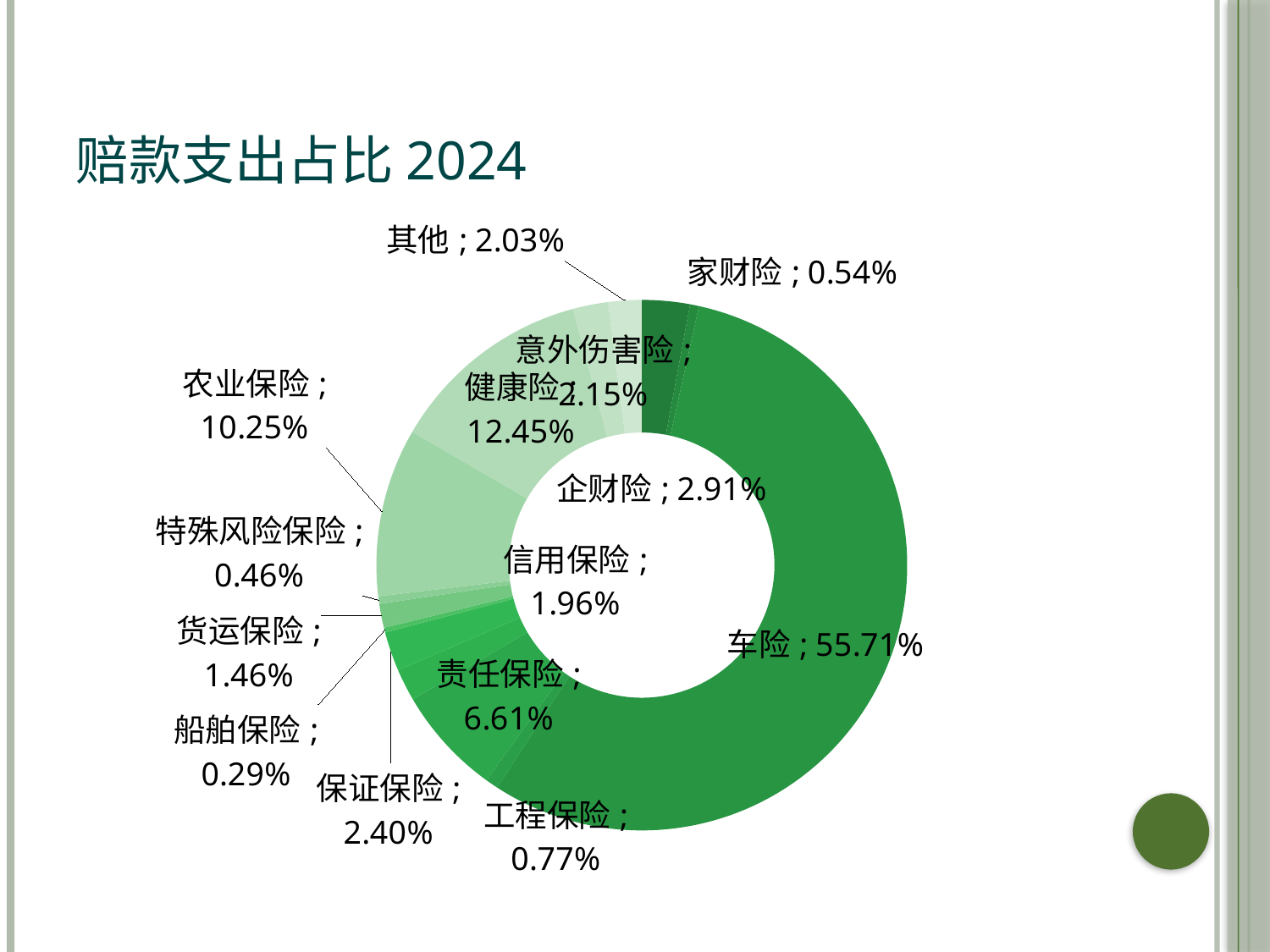
What is the value shown for 农业保险? 10.25% What is the value shown for 健康险? 12.45% What is the value shown for 船舶保险? 0.29% What is the title of the chart? 赔款支出占比 2024 What kind of chart is shown on the slide? Doughnut (pie) chart Which category has the largest share in the chart? 车险 What is the value shown for 意外伤害险? 2.15% Which category has the smallest share in the chart? 船舶保险 Which is larger, the share of 责任保险 or the share of 保证保险? 责任保险 How many categories are shown in the chart? 14 What is the difference between the shares of 健康险 and 农业保险? 2.20% What share of the chart does 车险 account for? 55.71%